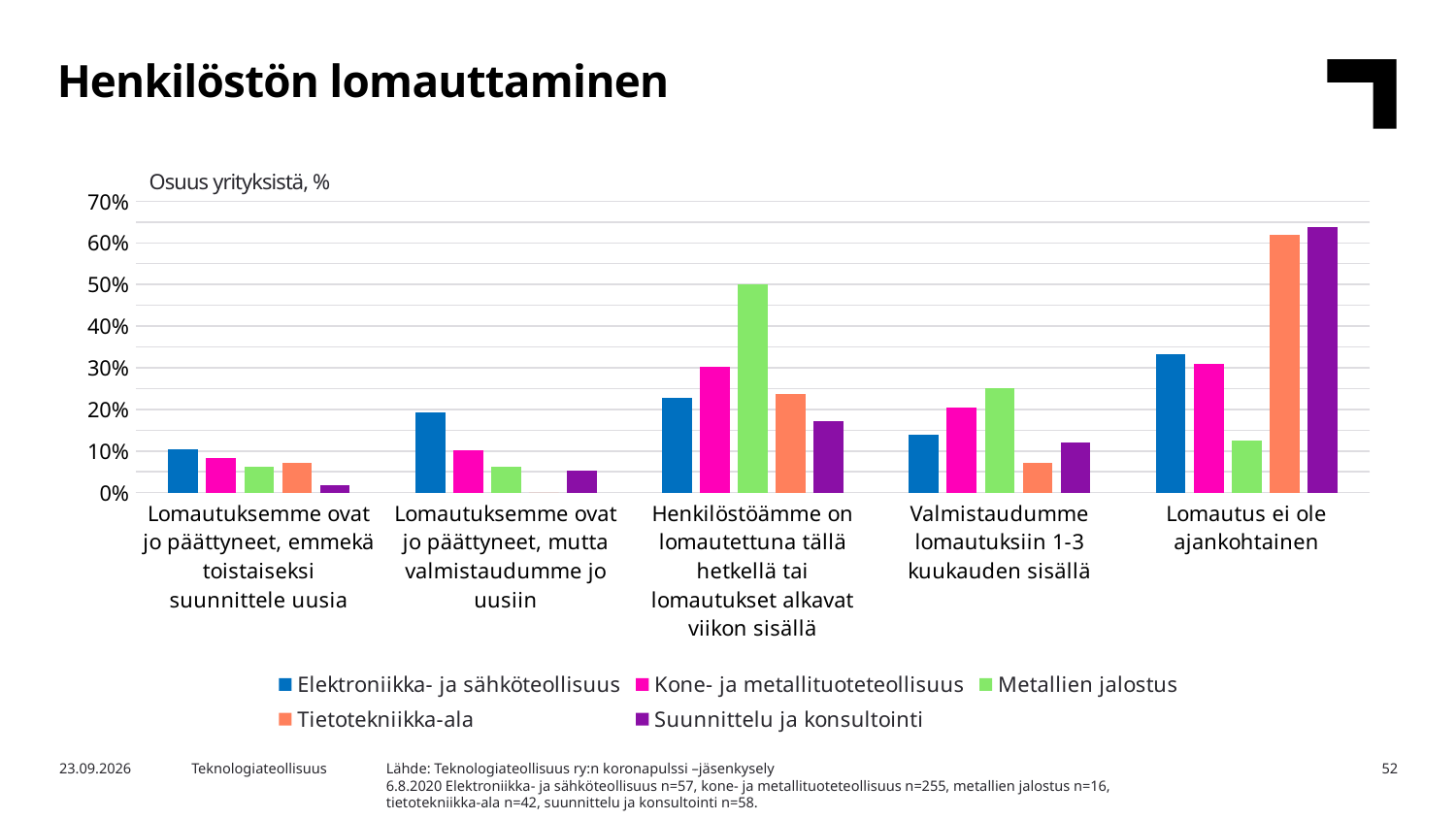
Is the value for Metallien jalostus in the category "Henkilöstöämme on lomautettuna tällä hetkellä tai lomautukset alkavat viikon sisällä" greater or less than 40%? greater In the category "Lomautuksemme ovat jo päättyneet, mutta valmistaudumme jo uusiin", which is larger: Elektroniikka- ja sähköteollisuus or Kone- ja metallituoteteollisuus? Elektroniikka- ja sähköteollisuus How many series does the legend list? 5 How many categories are shown along the x axis? 5 In the category "Valmistaudumme lomautuksiin 1-3 kuukauden sisällä", which is larger: Metallien jalostus or Tietotekniikka-ala? Metallien jalostus Is the value for Tietotekniikka-ala in the category "Lomautus ei ole ajankohtainen" greater or less than 50%? greater What label is shown above the vertical axis of the chart? Osuus yrityksistä, % For the series Suunnittelu ja konsultointi, which category has the highest value? Lomautus ei ole ajankohtainen Is the value for Elektroniikka- ja sähköteollisuus in the category "Lomautus ei ole ajankohtainen" greater or less than 30%? greater What kind of chart is shown on the slide? bar chart Which series has the lowest value in the category "Lomautuksemme ovat jo päättyneet, emmekä toistaiseksi suunnittele uusia"? Suunnittelu ja konsultointi Which series has the highest value in the category "Henkilöstöämme on lomautettuna tällä hetkellä tai lomautukset alkavat viikon sisällä"? Metallien jalostus